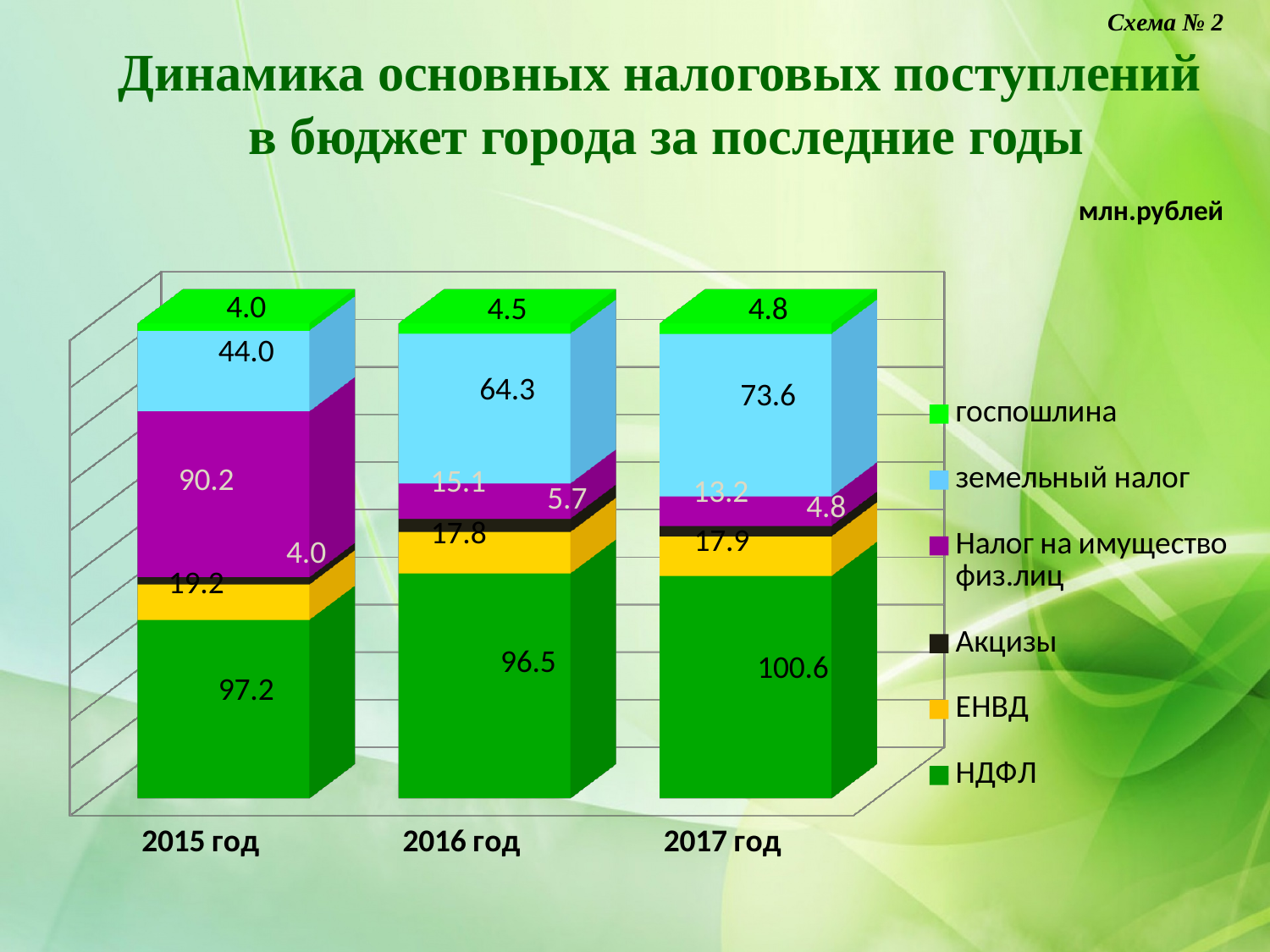
What is the value of земельный налог for 2016 год? 64.3 How many years (categories) are shown on the x axis? 3 What is the difference between the земельный налог values for 2017 год and 2015 год? 29.6 What is the value of Налог на имущество физ.лиц for 2015 год? 90.2 Which is larger: ЕНВД in 2015 год or ЕНВД in 2016 год? 2015 год What is the total of the stacked bar for 2016 год? 203.9 What is the value of Акцизы for 2016 год? 5.7 What is the value of НДФЛ for 2017 год? 100.6 In which year is the value of земельный налог the highest? 2017 год How many series does the legend list? 6 What type of chart is shown on the slide? Stacked bar chart In which year is the value of Налог на имущество физ.лиц the lowest? 2017 год